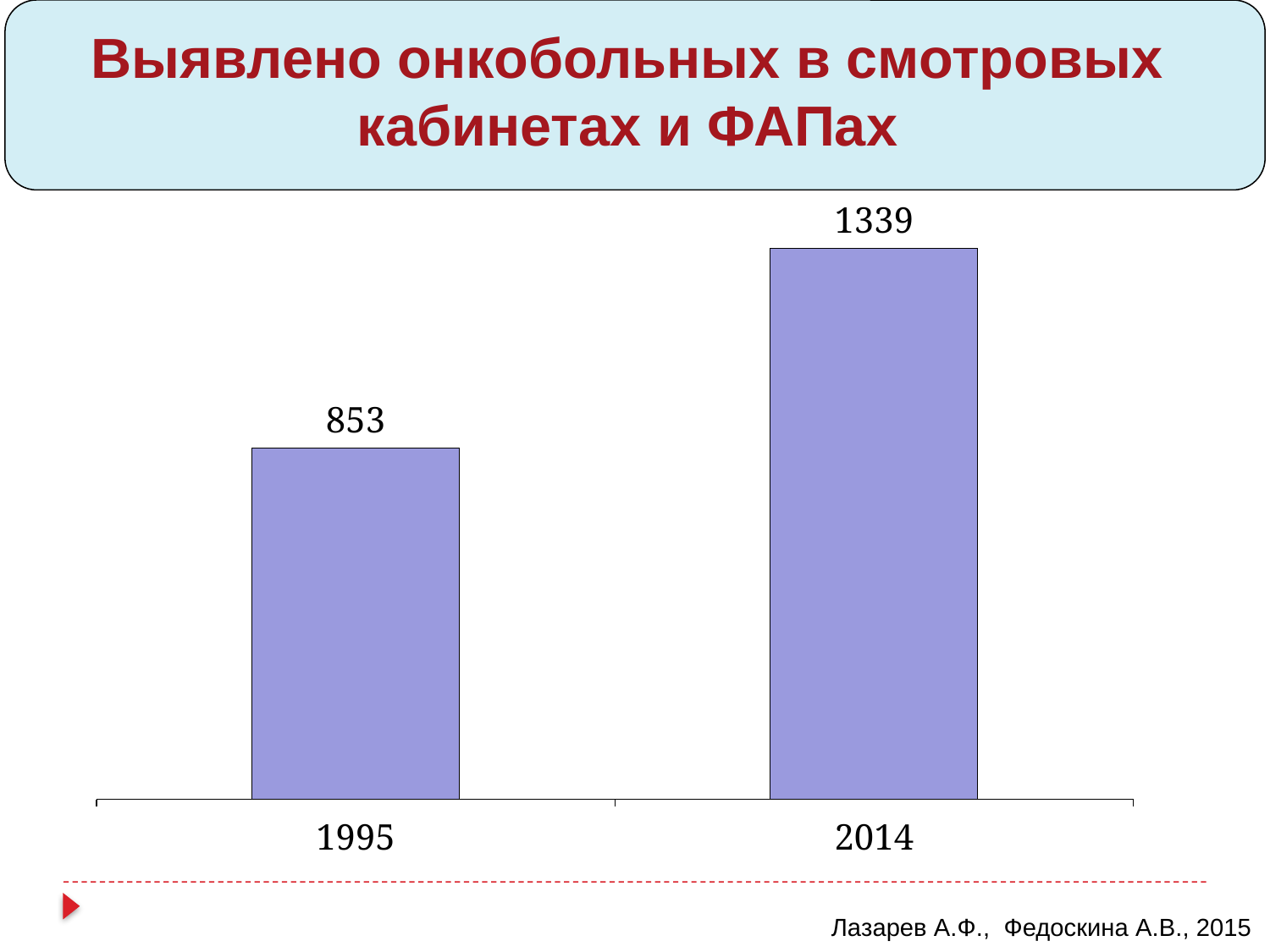
What colour are the bars in the chart? purple How many categories are shown on the x axis? 2 Do the values rise or fall from 1995 to 2014? rise Which year has the lowest value? 1995 Which year has the highest value? 2014 What is the title of the slide? Выявлено онкобольных в смотровых кабинетах и ФАПах What is the value for 1995? 853 What kind of chart is shown on the slide? bar chart What is the value for 2014? 1339 Which is larger, the value for 1995 or the value for 2014? 2014 What is the difference between the values for 2014 and 1995? 486